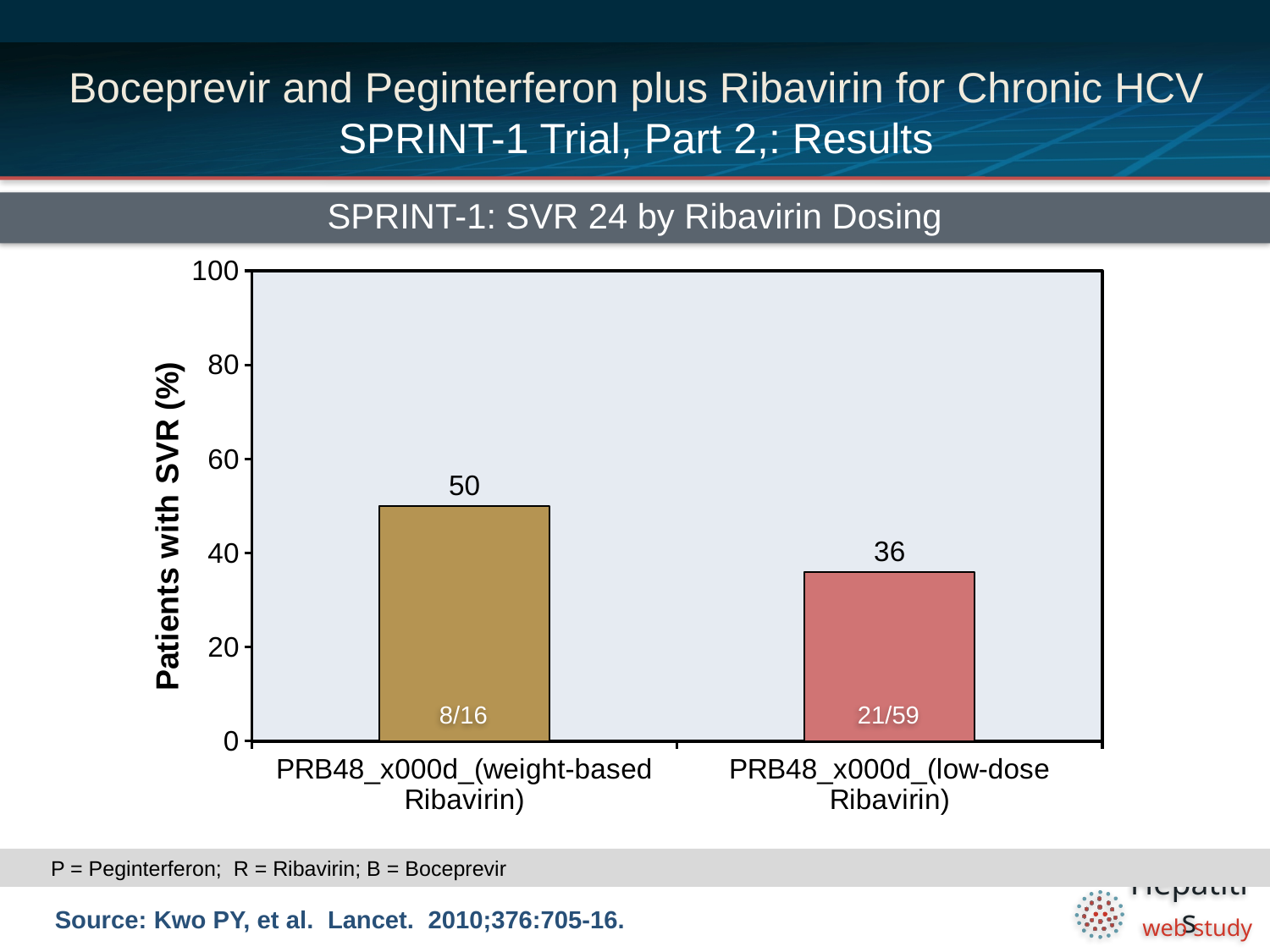
Is the SVR rate for the low-dose Ribavirin group greater or less than 40? less What fraction of patients is shown inside the bar for the low-dose Ribavirin group? 21/59 What kind of chart is shown on the slide? Bar chart Which group has the lower SVR rate? PRB48 (low-dose Ribavirin) What is the SVR rate (%) for the PRB48 (low-dose Ribavirin) group? 36 How many groups are plotted in the chart? 2 Which group has the higher SVR rate? PRB48 (weight-based Ribavirin) What is the title of the chart? SPRINT-1: SVR 24 by Ribavirin Dosing Is the SVR rate for the weight-based Ribavirin group greater or less than 40? greater What fraction of patients is shown inside the bar for the weight-based Ribavirin group? 8/16 What is the difference in SVR rate (percentage points) between the weight-based and low-dose Ribavirin groups? 14 What is the SVR rate (%) for the PRB48 (weight-based Ribavirin) group? 50